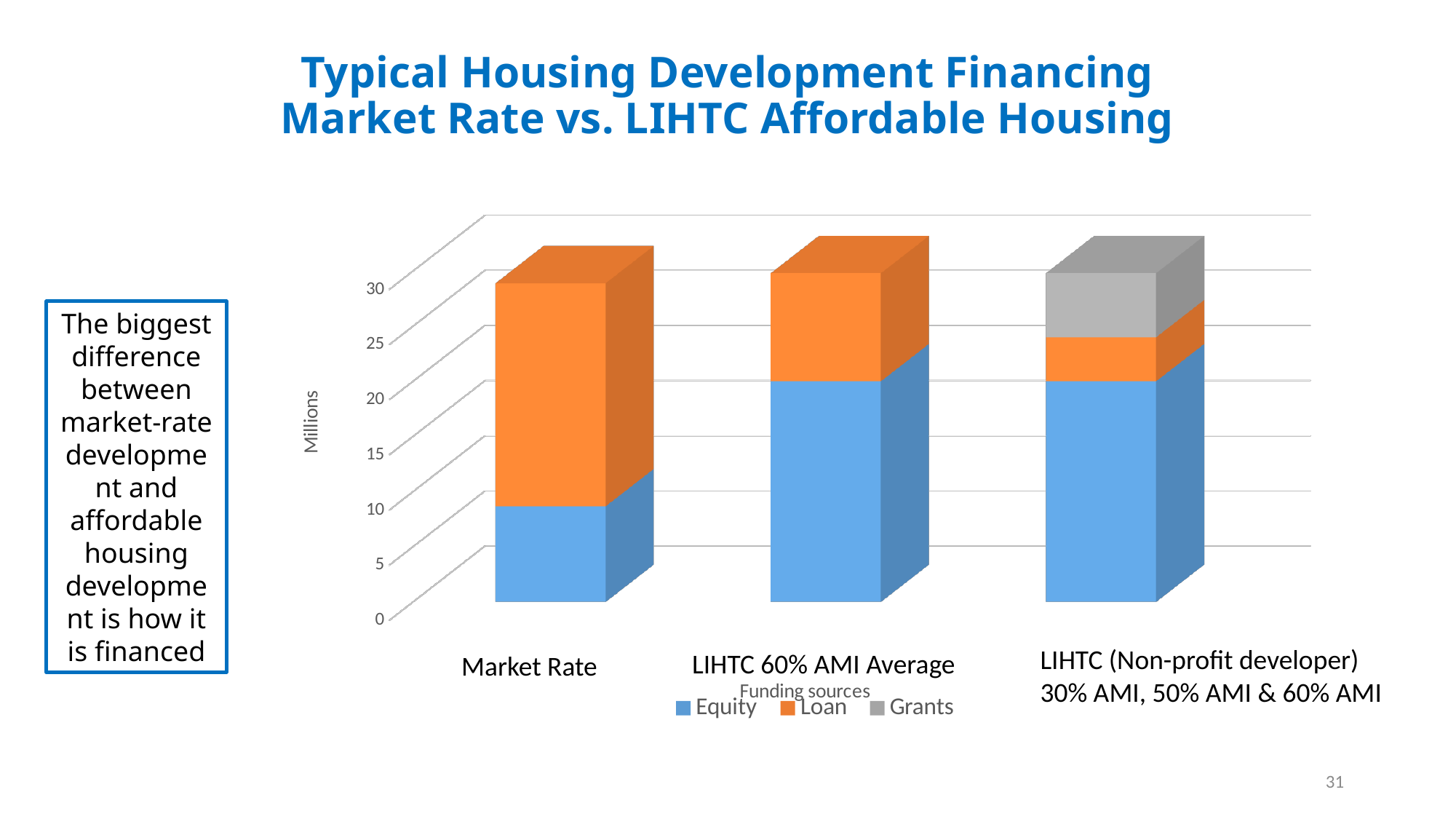
Which is larger, the Equity value for Market Rate or the Equity value for LIHTC 60% AMI Average? LIHTC 60% AMI Average What are the three series listed in the chart's legend? Equity, Loan, Grants Which category has the smallest Equity segment? Market Rate Is the Equity value for Market Rate greater or less than 15? less How many categories are shown on the x axis of the chart? 3 How many series does the chart's legend list? 3 Is the total of the Market Rate bar greater or less than 25? greater What kind of chart is shown on the slide? Stacked bar chart Is the Equity value for LIHTC 60% AMI Average greater or less than 15? greater What is the label on the vertical axis of the chart? Millions Which category has the largest Loan segment? Market Rate Which category is the only one with a Grants segment? LIHTC (Non-profit developer) 30% AMI, 50% AMI & 60% AMI